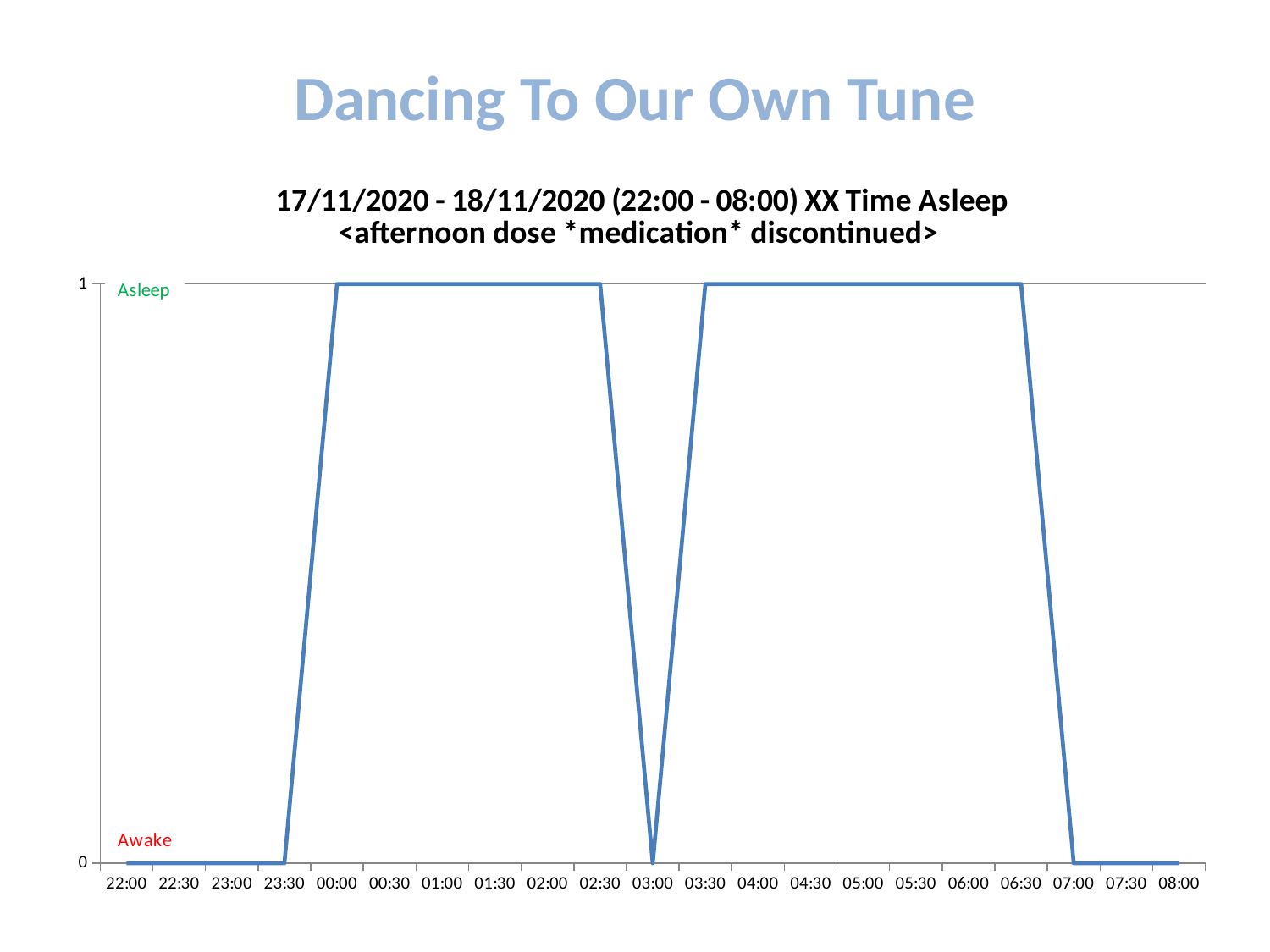
Which is larger, the value at 00:30 or the value at 23:00? 00:30 What is the value at 03:00? 0 Does the value rise or fall between 06:30 and 07:00? fall What label is shown in green next to the value 1 on the y axis? Asleep What is the value at 07:30? 0 How many time points are labelled on the x axis? 21 What kind of chart is shown on the slide? line chart What is the value at 01:00? 1 What is the value at 05:00? 1 What is the difference between the value at 04:00 and the value at 07:00? 1 Does the value rise or fall between 23:30 and 00:00? rise What is the value at 22:30? 0